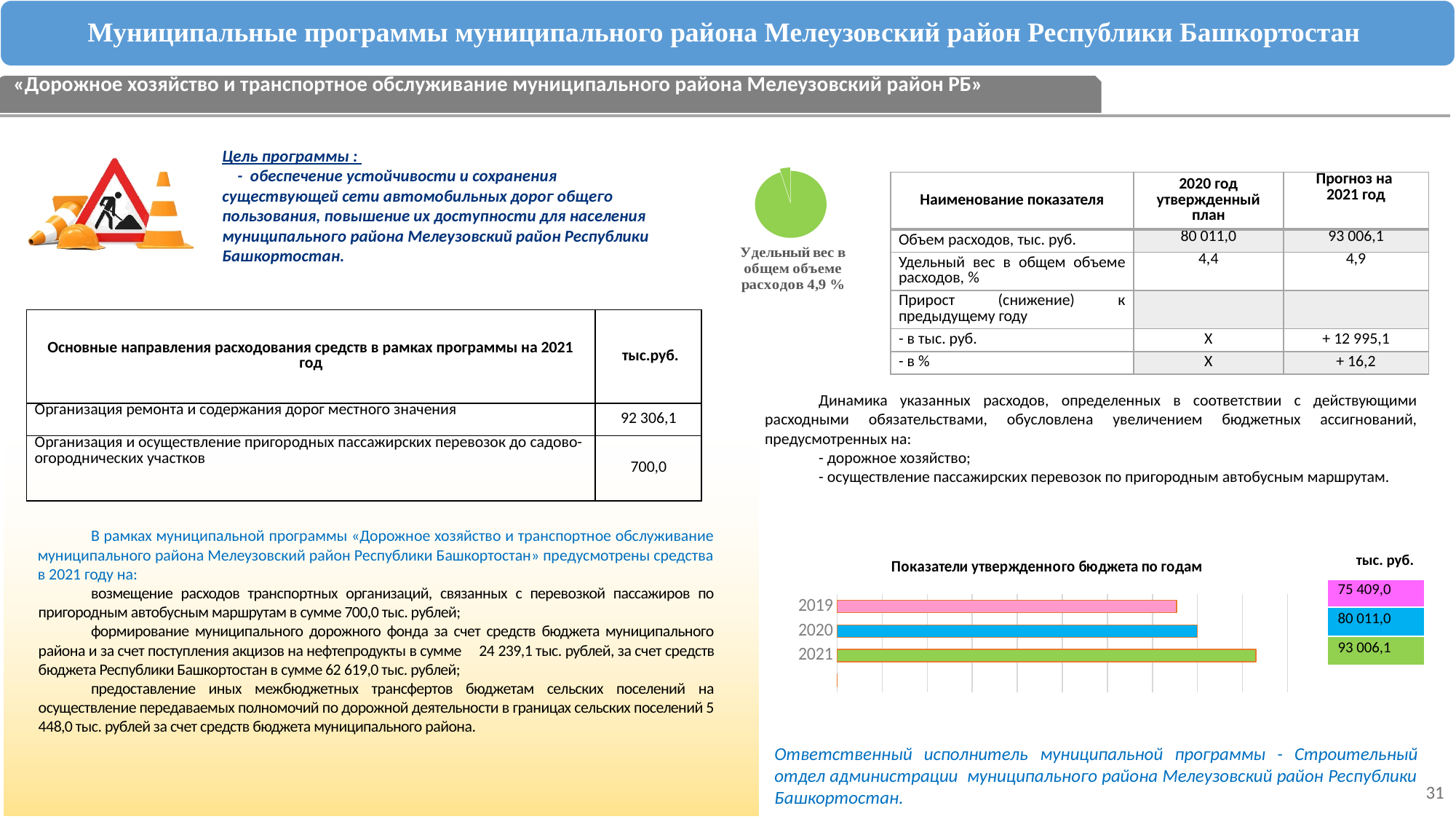
What unit is indicated for the chart 'Показатели утвержденного бюджета по годам'? тыс. руб. In the chart 'Показатели утвержденного бюджета по годам', what is the value for 2020? 80 011,0 In the chart 'Показатели утвержденного бюджета по годам', which is larger, the value for 2019 or the value for 2020? 2020 In the chart 'Показатели утвержденного бюджета по годам', which year has the highest value? 2021 In the chart 'Показатели утвержденного бюджета по годам', do the values rise or fall from 2019 to 2021? rise In the pie chart at the top of the slide, what share of total expenditures does the highlighted slice represent? 4,9 % In the chart 'Показатели утвержденного бюджета по годам', what is the value for 2021? 93 006,1 In the chart 'Показатели утвержденного бюджета по годам', what is the value for 2019? 75 409,0 In the chart 'Показатели утвержденного бюджета по годам', what is the difference between the 2021 and 2020 values? 12 995,1 What kind of chart is 'Показатели утвержденного бюджета по годам'? bar chart How many years are shown in the chart 'Показатели утвержденного бюджета по годам'? 3 In the chart 'Показатели утвержденного бюджета по годам', which year has the lowest value? 2019